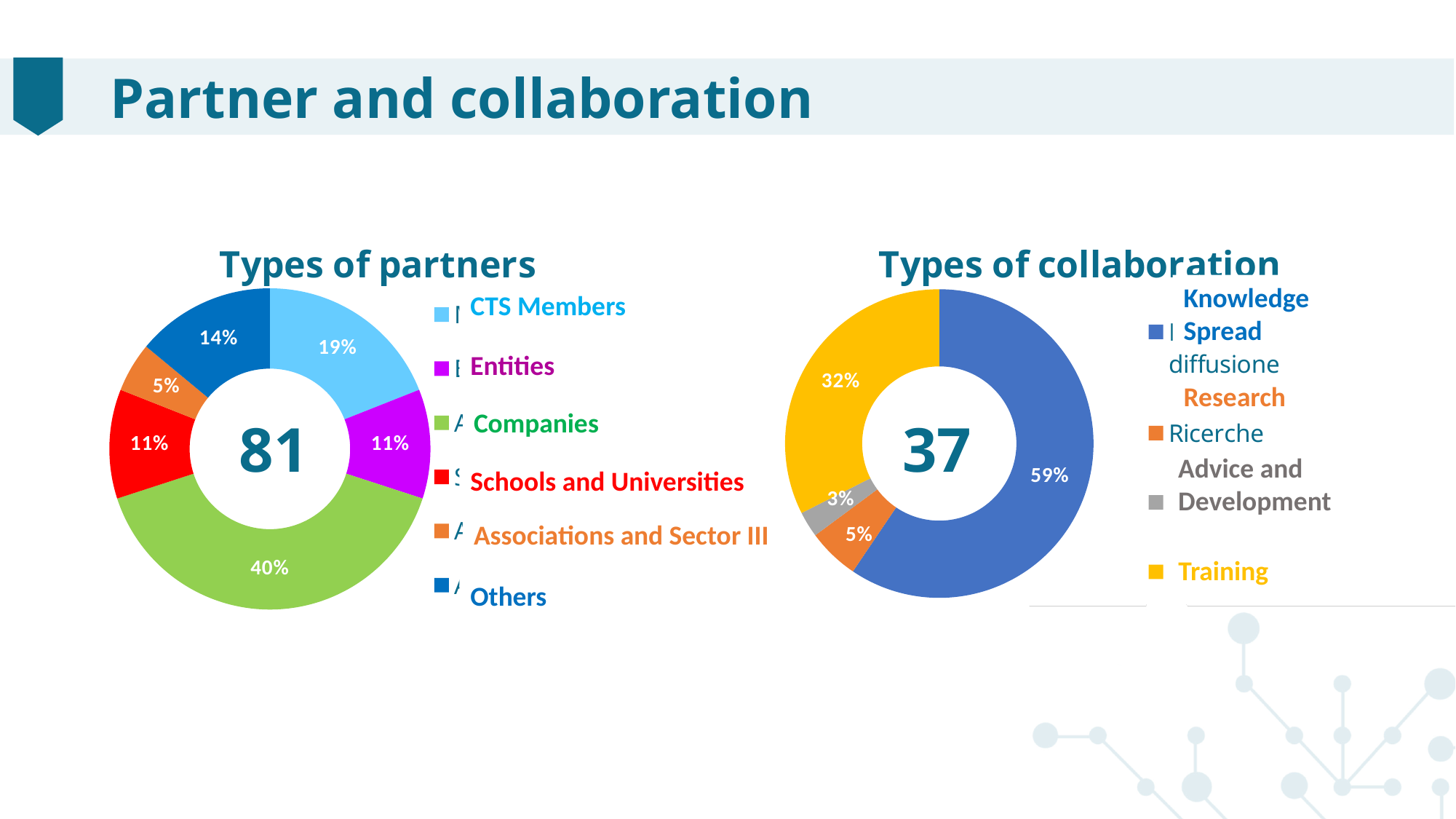
In the 'Types of partners' chart, which category has the largest share? Companies In the 'Types of collaboration' chart, which is larger: Research or Training? Training In the 'Types of partners' chart, how many categories are shown? 6 In the 'Types of partners' chart, what share do Companies have? 40% In the 'Types of collaboration' chart, which category has the smallest share? Advice and Development What number is shown in the centre of the 'Types of partners' chart? 81 What type of chart is the 'Types of collaboration' chart? Pie (donut) chart In the 'Types of partners' chart, which category has the smallest share? Associations and Sector III In the 'Types of collaboration' chart, which category has the largest share? Knowledge Spread In the 'Types of partners' chart, what share do CTS Members have? 19% In the 'Types of partners' chart, what is the difference in percentage points between Companies and Others? 26 In the 'Types of collaboration' chart, what share does Training have? 32%